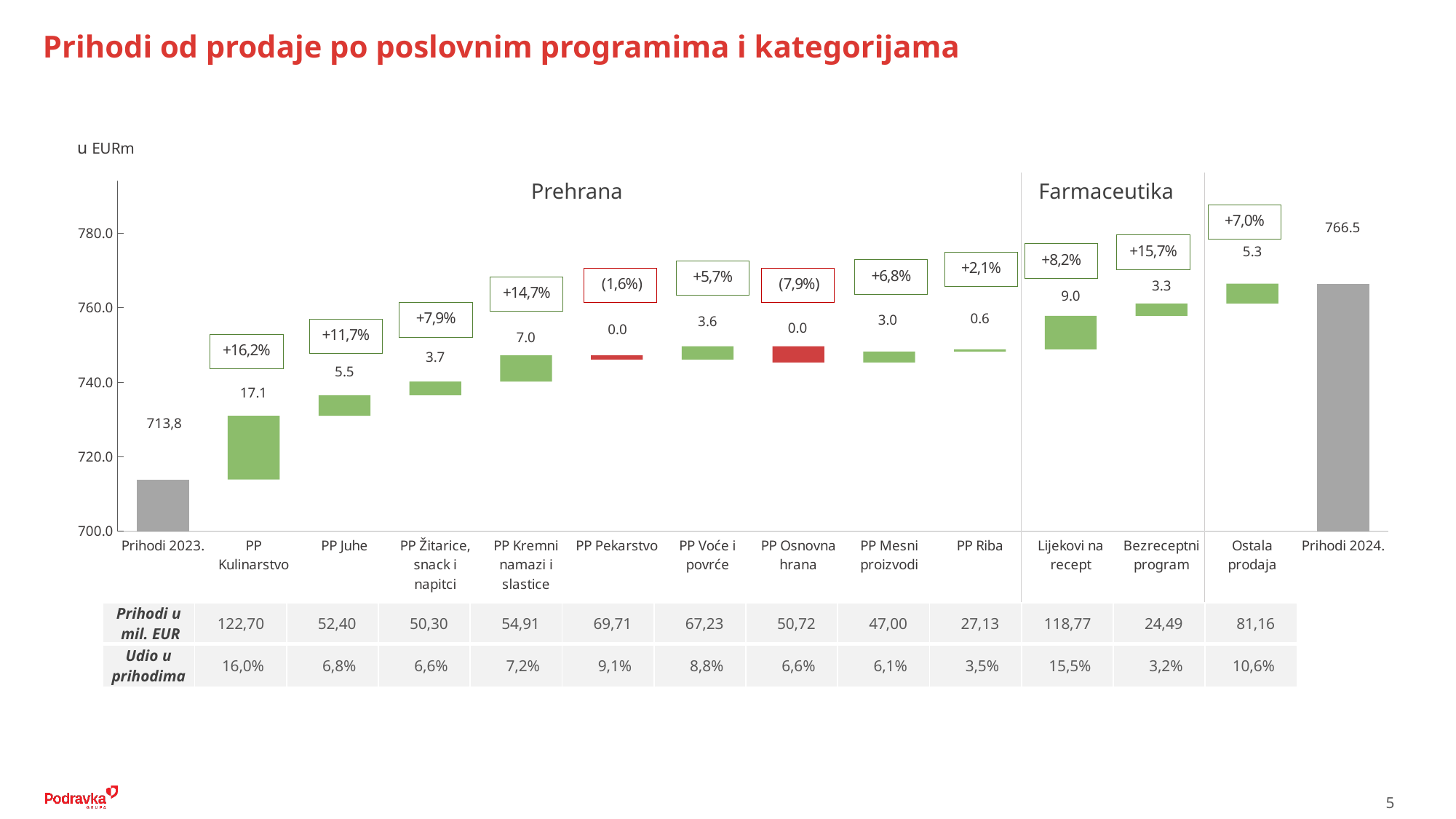
What is the increment shown for Lijekovi na recept? 9.0 What percentage change is shown for PP Pekarstvo? (1,6%) Is the Prihodi 2024. bar greater or less than 760.0? greater What percentage change is shown for Bezreceptni program? +15,7% Which has the larger increment, PP Juhe or PP Kremni namazi i slastice? PP Kremni namazi i slastice What is the value of the Prihodi 2023. bar? 713,8 What is the title of the slide? Prihodi od prodaje po poslovnim programima i kategorijama What is the value of the Prihodi 2024. bar? 766.5 What is the increment shown for PP Kulinarstvo? 17.1 Which business program contributes the largest increment in the chart? PP Kulinarstvo What is the difference between the Prihodi 2024. and Prihodi 2023. values? 52.7 What kind of chart is shown on the slide? Waterfall chart